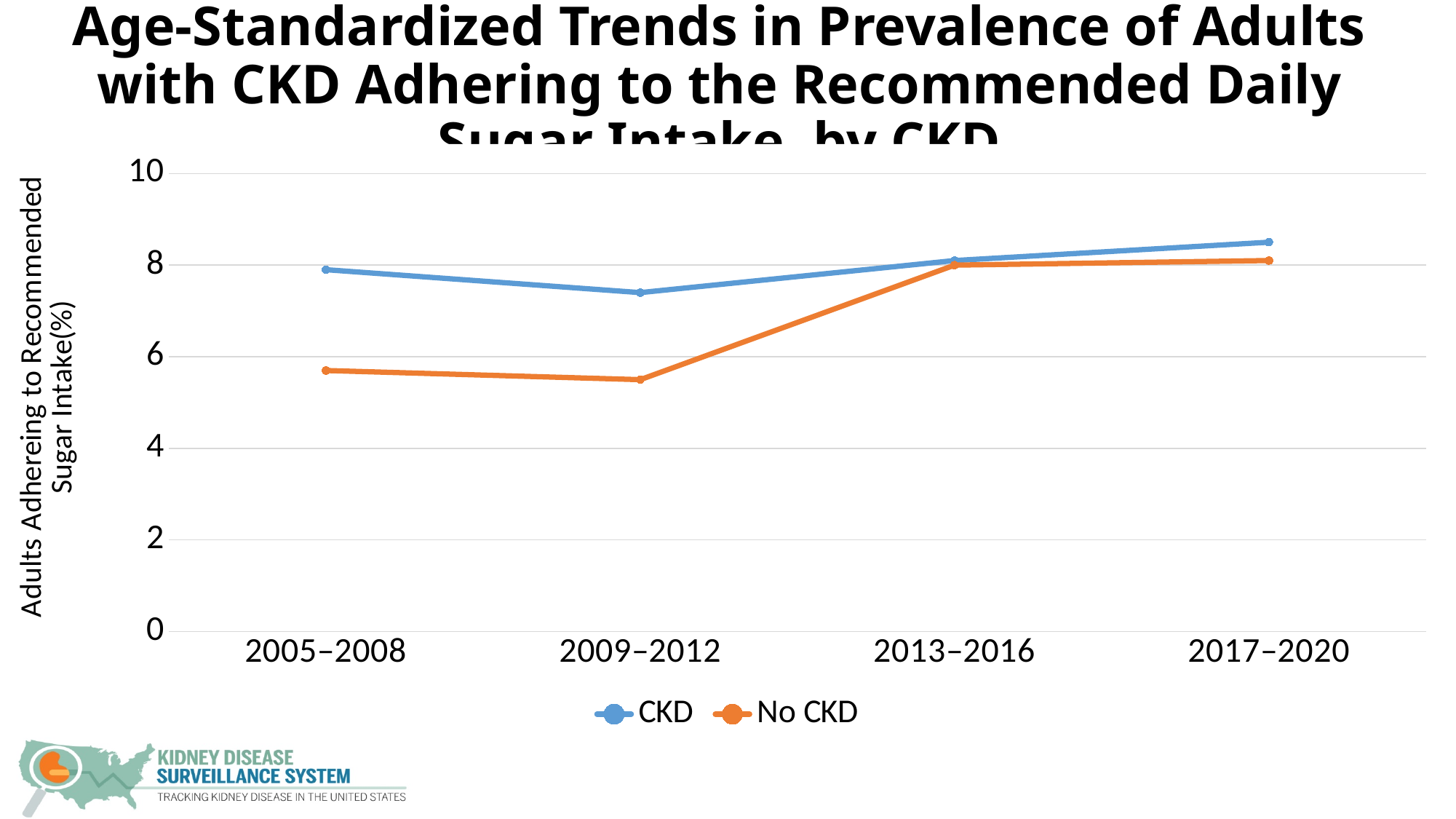
In which period is the CKD series at its lowest? 2009–2012 Is the value for CKD in 2005–2008 greater or less than 6? greater In 2005–2008, which series has the larger value, CKD or No CKD? CKD Is the value for CKD in 2009–2012 greater or less than 8? less How many series does the legend list? 2 In which period is the CKD series at its highest? 2017–2020 How many time periods are plotted along the x axis? 4 Is the value for No CKD in 2009–2012 greater or less than 6? less What colour is the line for the No CKD series? orange Does the No CKD series rise or fall from 2009–2012 to 2013–2016? rise What kind of chart is shown on the slide? line chart